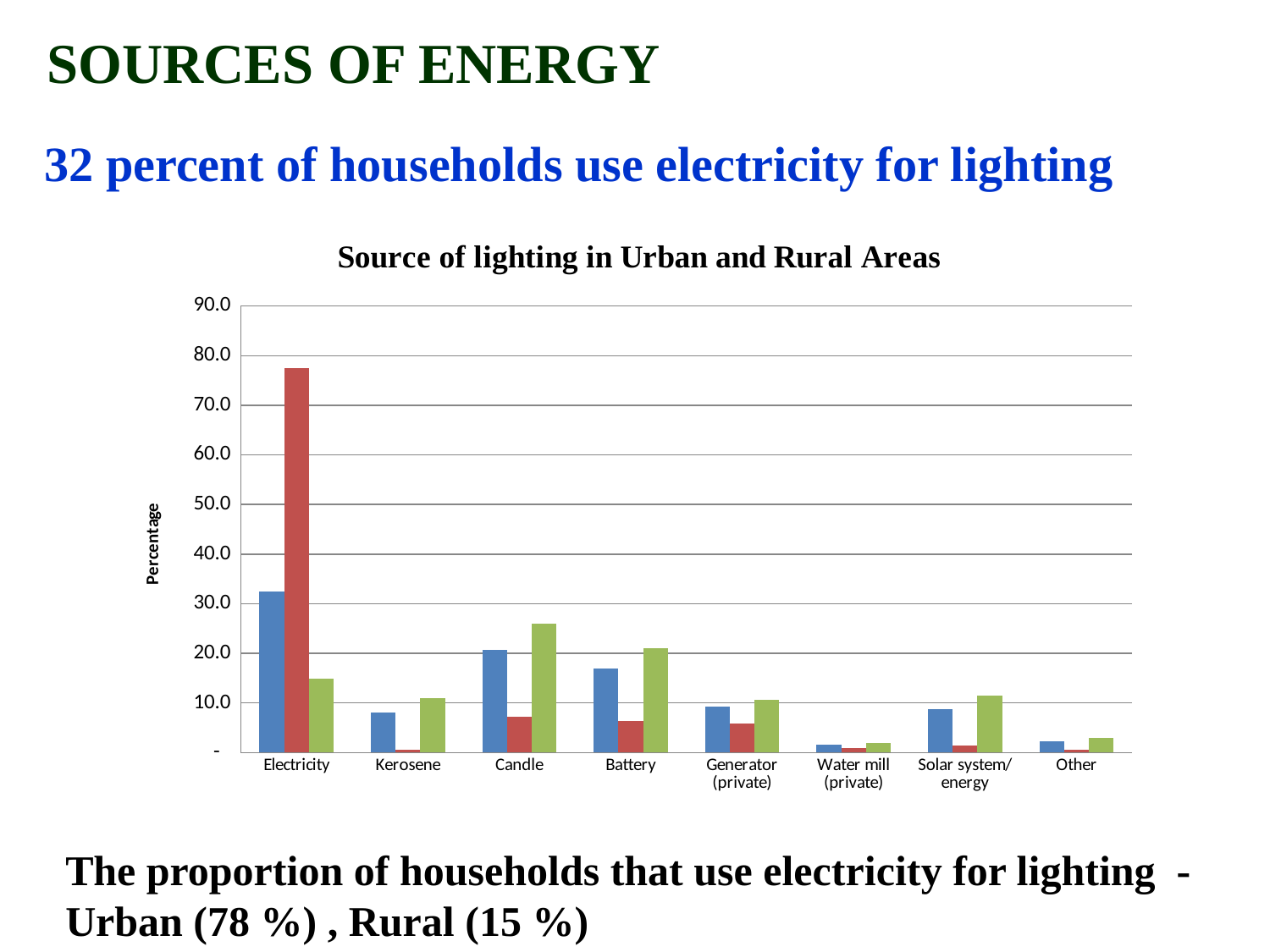
How many bars are plotted for each category? 3 Which category has the tallest red bar? Electricity Which category has the tallest blue bar? Electricity What is the label on the y axis? Percentage What is the title of the chart? Source of lighting in Urban and Rural Areas Is the green bar for Candle greater or less than 20.0? greater What kind of chart is shown on the slide? bar chart Which category has the tallest green bar? Candle Is the red bar for Electricity greater or less than 70.0? greater How many lighting source categories are shown on the x axis? 8 Is the blue bar for Battery greater or less than 20.0? less Which is larger, the green bar for Candle or the green bar for Battery? Candle